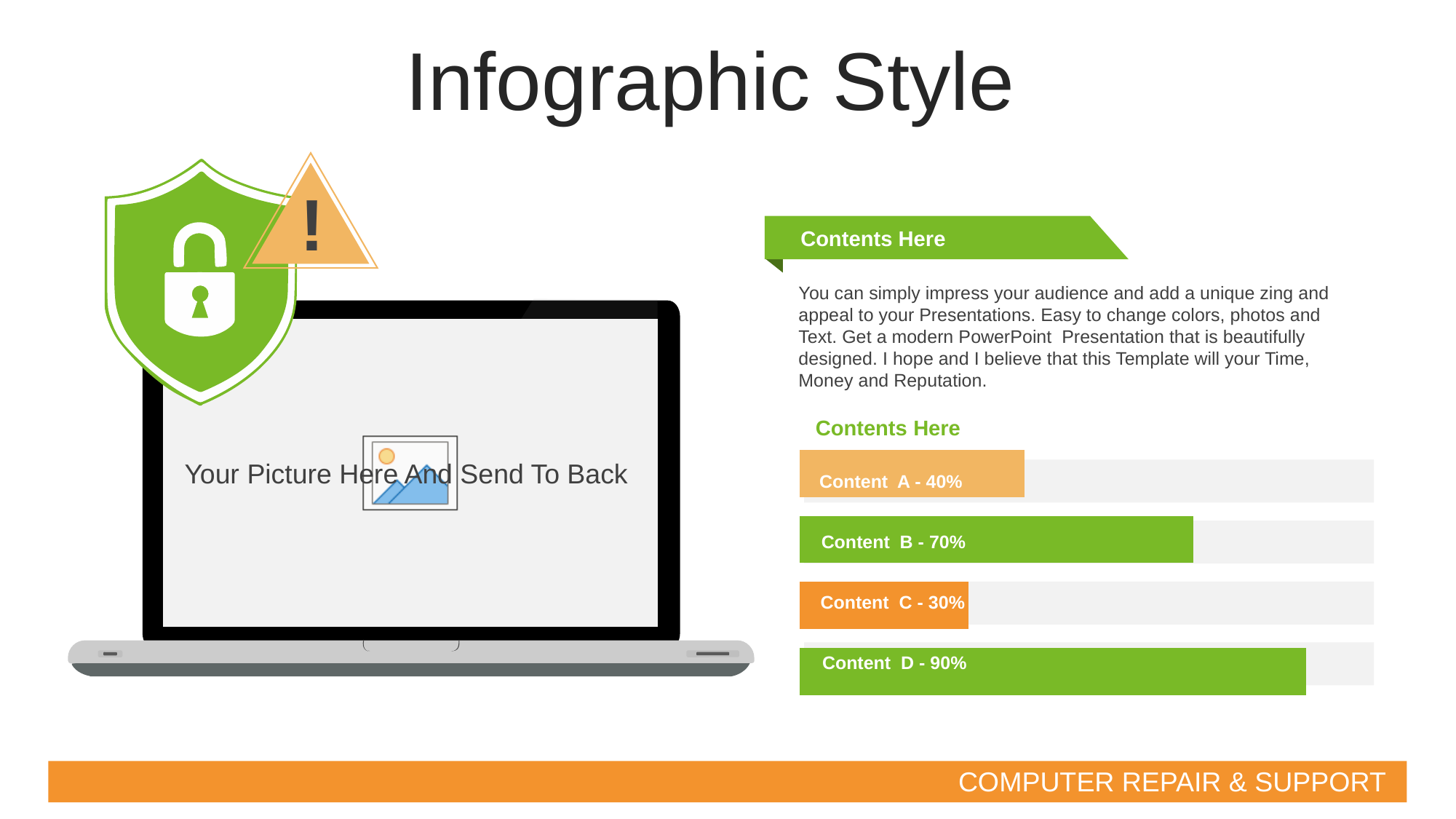
What is the value for Content B? 70% What is the value for Content D? 90% What is the difference between the values for Content B and Content C? 40% What is the difference between the values for Content D and Content A? 50% Which content has the highest value? Content D What is the value for Content C? 30% How many content bars are shown in the chart? 4 What colour is the bar for Content C? Orange What kind of chart is shown on the slide? Bar chart Which content has the lowest value? Content C Which is larger, the value for Content A or the value for Content B? Content B What is the value for Content A? 40%